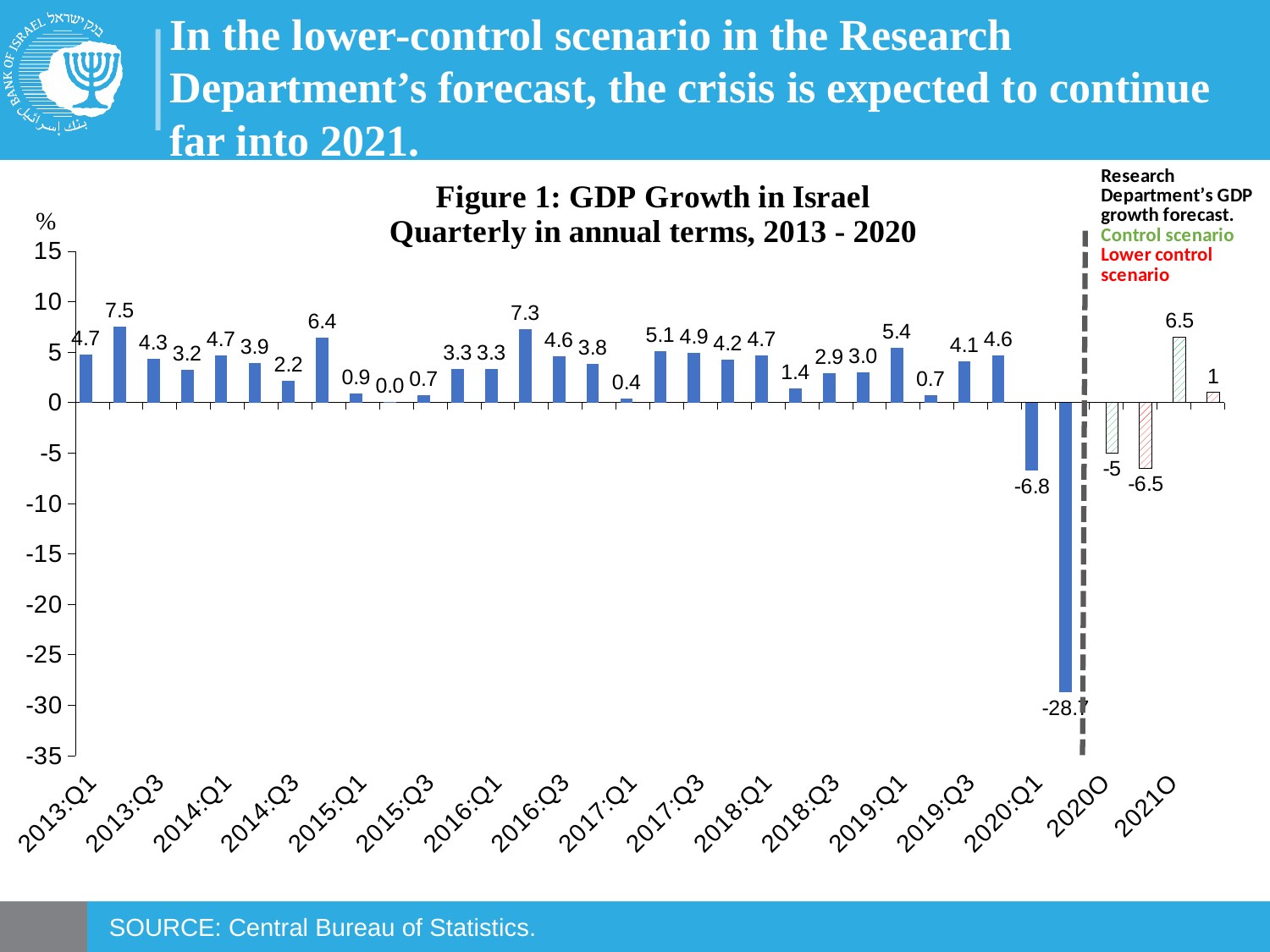
What is the title of the chart? Figure 1: GDP Growth in Israel Quarterly in annual terms, 2013 - 2020 Is the GDP growth value for 2020:Q1 greater or less than -5? less What is the Research Department's control scenario forecast for 2021? 6.5 What is the highest quarterly GDP growth value printed on the chart? 7.5 What is the Research Department's lower control scenario forecast for 2020? -6.5 Which is larger, the GDP growth value for 2019:Q1 or for 2019:Q3? 2019:Q1 What type of chart is Figure 1? bar chart What is the GDP growth value for 2017:Q1? 0.4 What is the GDP growth value for 2019:Q1? 5.4 What is the GDP growth value for 2020:Q1? -6.8 What is the GDP growth value for 2013:Q1? 4.7 What is the difference between the control scenario and lower control scenario forecasts for 2021? 5.5